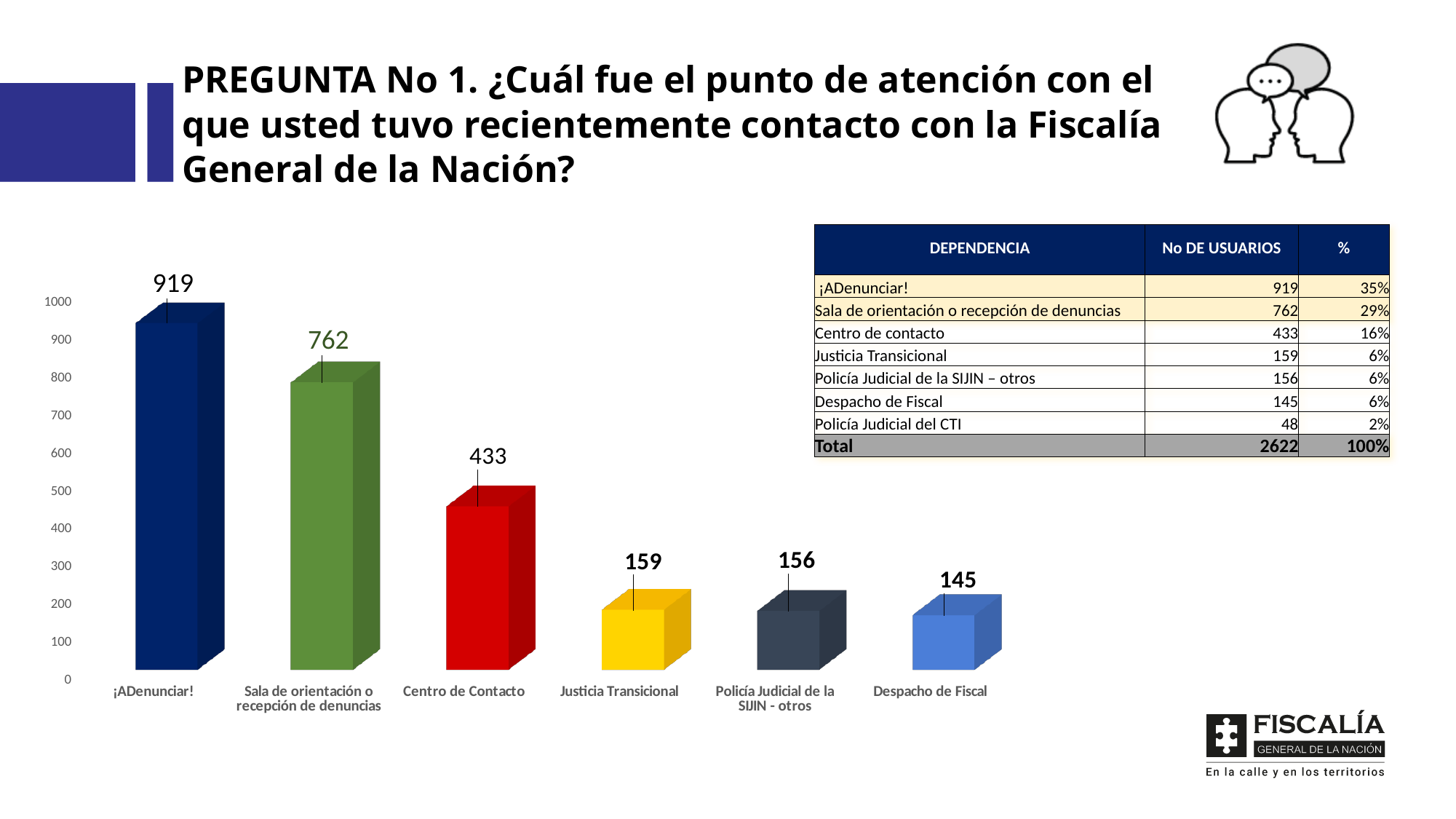
What is the value for ¡ADenunciar! in the bar chart? 919 What is the difference between the values for ¡ADenunciar! and Sala de orientación o recepción de denuncias? 157 How many categories are shown in the bar chart? 6 Which category has the highest value in the bar chart? ¡ADenunciar! Do the values rise or fall from left to right along the x axis of the bar chart? fall What kind of chart is shown on the slide? bar chart Is the value for Centro de Contacto greater or less than 500? less What is the value for Despacho de Fiscal in the bar chart? 145 What is the difference between the values for Centro de Contacto and Justicia Transicional? 274 Which is larger, the value for Sala de orientación o recepción de denuncias or the value for Centro de Contacto? Sala de orientación o recepción de denuncias What is the value for Centro de Contacto in the bar chart? 433 Which category has the lowest value in the bar chart? Despacho de Fiscal